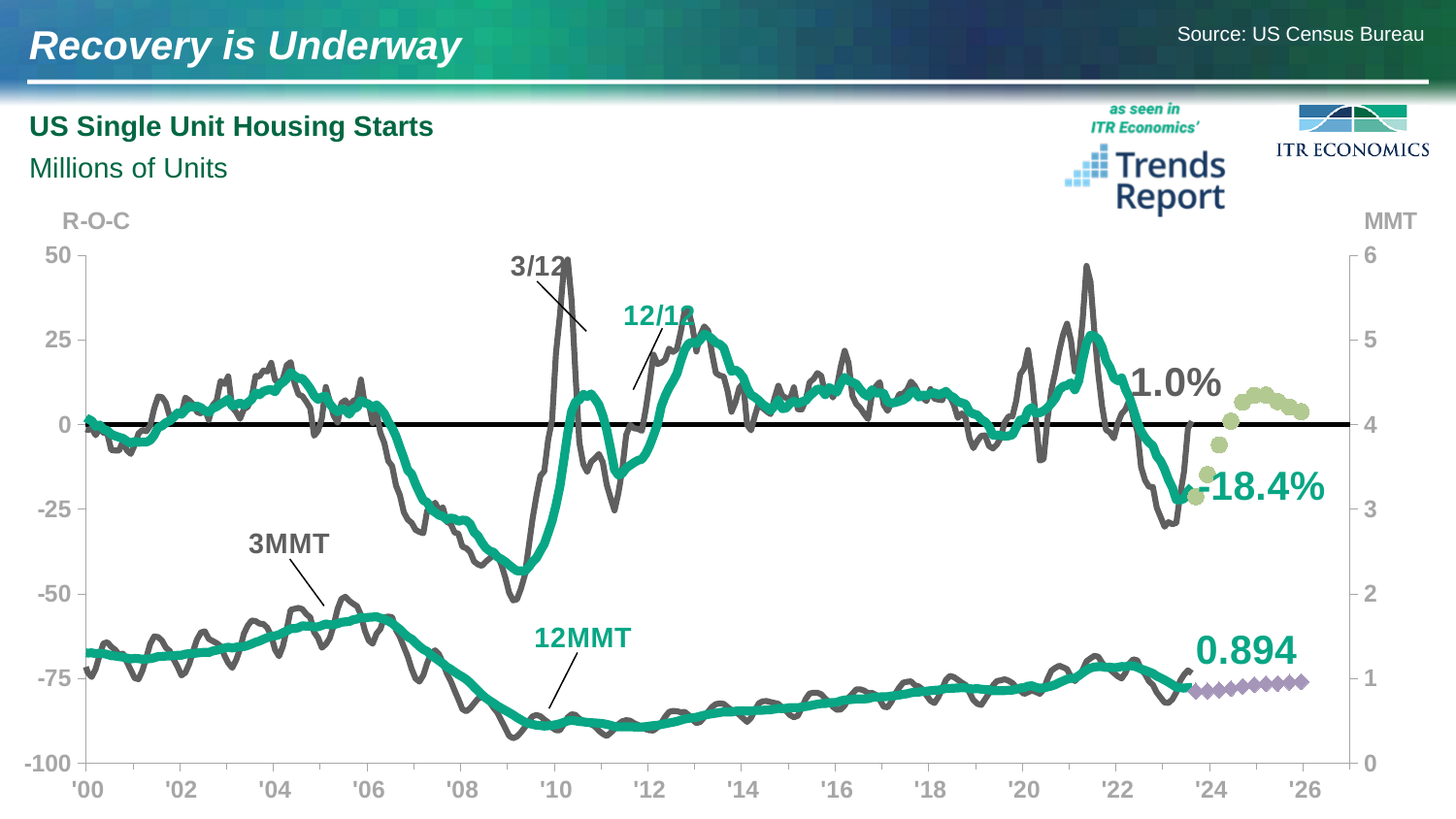
Which is larger, the 12MMT value around '06 or the 12MMT value around '10? '06 What is the source cited for the chart data? US Census Bureau Is the 12MMT value around '10 greater or less than 1 on the MMT axis? less How many data series are labeled on the chart (3/12, 12/12, 3MMT, 12MMT)? 4 What is the latest 12/12 rate-of-change value labeled on the chart? -18.4% What is the highest value shown on the right MMT axis? 6 Does the 12MMT line rise or fall between '10 and '22? rise What kind of chart is shown on the slide? line chart What is the highest value shown on the left R-O-C axis? 50 What is the latest 12MMT value labeled on the chart? 0.894 What value is labeled in gray near the end of the 3/12 line? 1.0% What is the title of the chart? US Single Unit Housing Starts